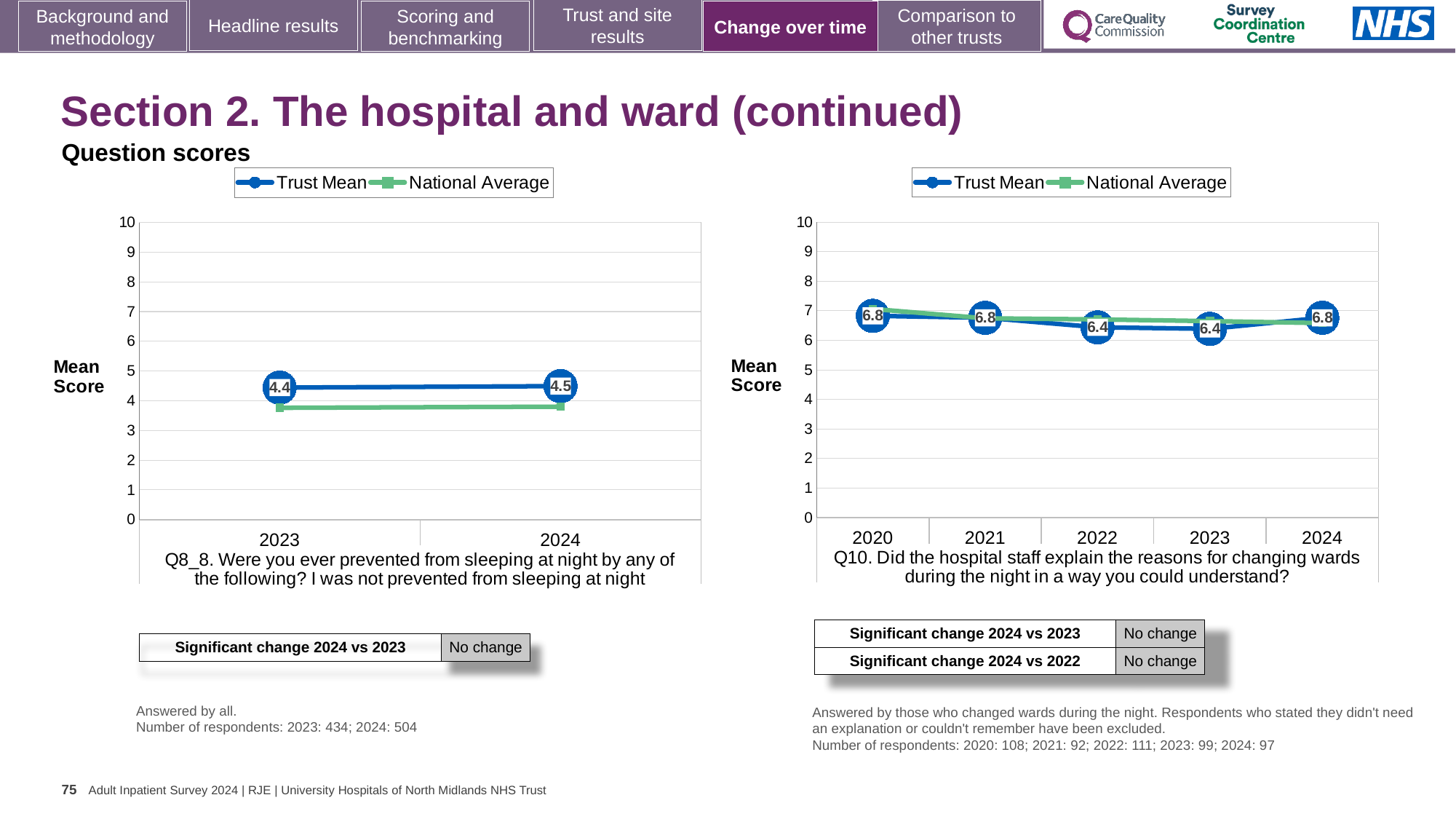
In the Q10 chart on the right, is the Trust Mean value for 2020 greater or less than 6? greater In the Q10 chart on the right, what is the Trust Mean score for 2024? 6.8 In the Q8_8 chart on the left, what is the Trust Mean score for 2023? 4.4 In the Q10 chart on the right, what is the Trust Mean score for 2022? 6.4 What type of chart is the Q10 chart on the right? Line chart In the Q10 chart on the right, how many years are shown on the x axis? 5 How many series does the legend of the Q8_8 chart on the left list? 2 In the Q8_8 chart on the left, by how much did the Trust Mean change from 2023 to 2024? 0.1 In the Q10 chart on the right, what is the difference between the Trust Mean in 2021 and in 2023? 0.4 In the Q8_8 chart on the left, what is the Trust Mean score for 2024? 4.5 In the Q8_8 chart on the left, which series has the higher value in 2023, Trust Mean or National Average? Trust Mean In the Q8_8 chart on the left, is the National Average value for 2024 greater or less than 4? less